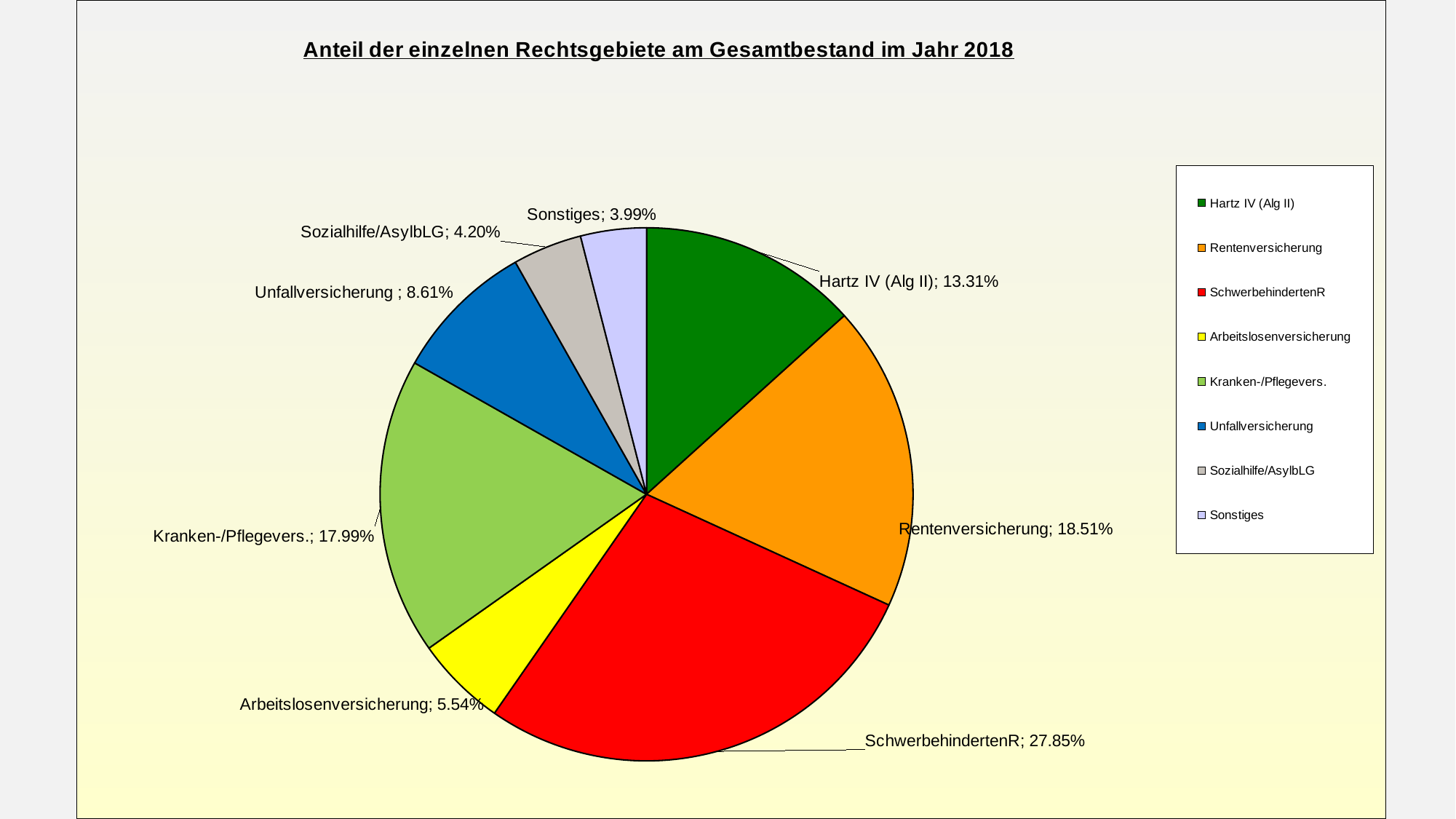
What kind of chart is shown on the slide? Pie chart What share of the pie does SchwerbehindertenR have? 27.85% What is the value shown for Rentenversicherung? 18.51% Which category has the largest slice of the pie? SchwerbehindertenR What is the difference between the shares of Rentenversicherung and Hartz IV (Alg II)? 5.20% What is the title of the chart? Anteil der einzelnen Rechtsgebiete am Gesamtbestand im Jahr 2018 What is the value shown for Kranken-/Pflegevers.? 17.99% What colour is the slice for Arbeitslosenversicherung? Yellow How many slices does the pie chart have? 8 What is the value shown for Sonstiges? 3.99% Which category has the smallest slice of the pie? Sonstiges Which is larger, the share of Unfallversicherung or the share of Arbeitslosenversicherung? Unfallversicherung